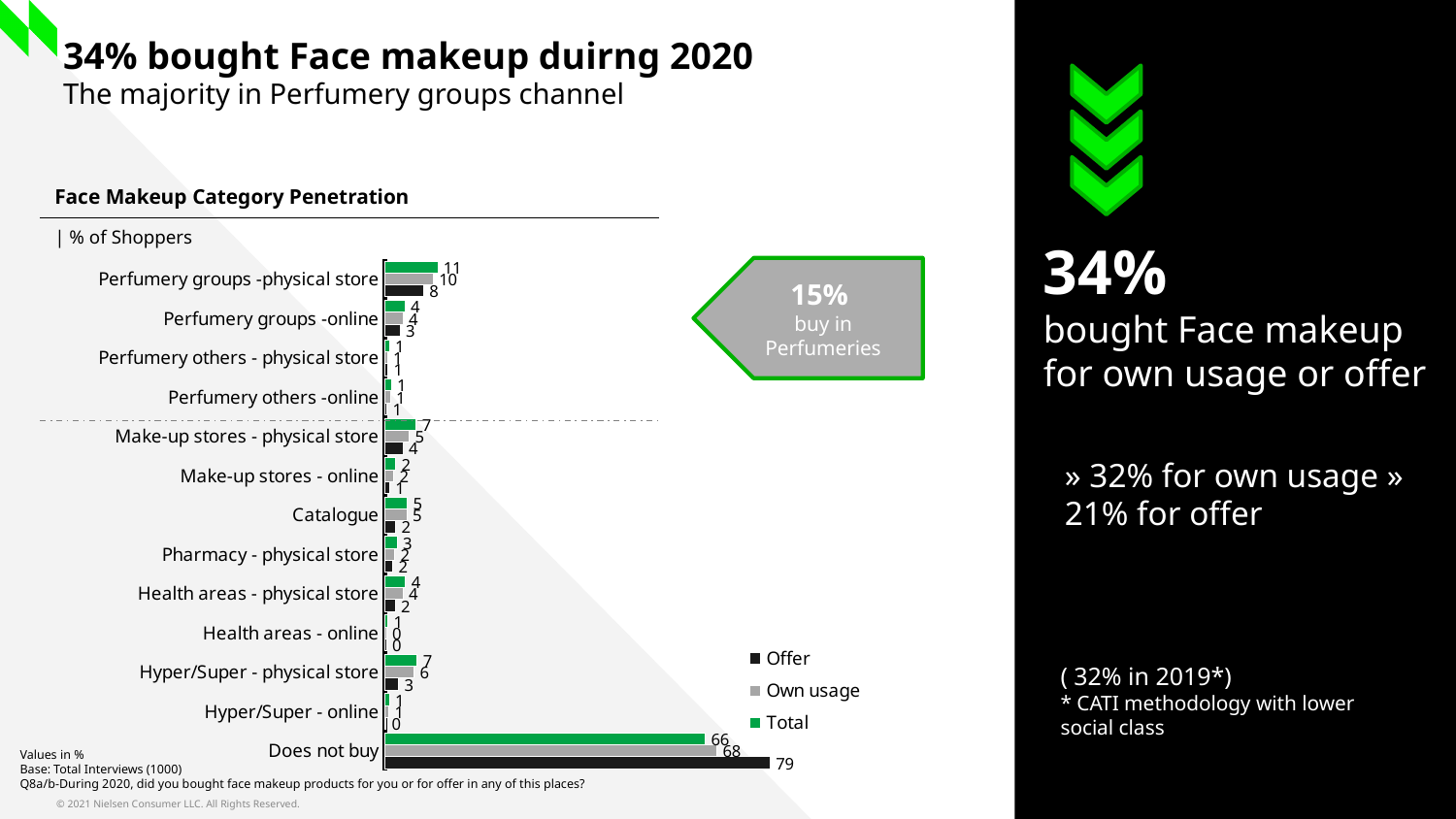
What kind of chart is shown under 'Face Makeup Category Penetration'? bar chart Which category has the highest Total value on the chart? Does not buy What is the Own usage value for 'Hyper/Super - physical store'? 6 What are the three legend entries of the Face Makeup Category Penetration chart? Offer, Own usage, Total What is the Offer value for 'Make-up stores - physical store'? 4 How many categories are plotted on the Face Makeup Category Penetration chart? 13 What is the difference between the Total and Offer values for 'Perfumery groups - physical store'? 3 What is the difference between the Offer value and the Total value for 'Does not buy'? 13 Which has the larger Total value: 'Make-up stores - physical store' or 'Catalogue'? Make-up stores - physical store What is the Total value for 'Perfumery groups - physical store'? 11 How many series does the legend of the Face Makeup Category Penetration chart list? 3 What is the Offer value for 'Does not buy'? 79